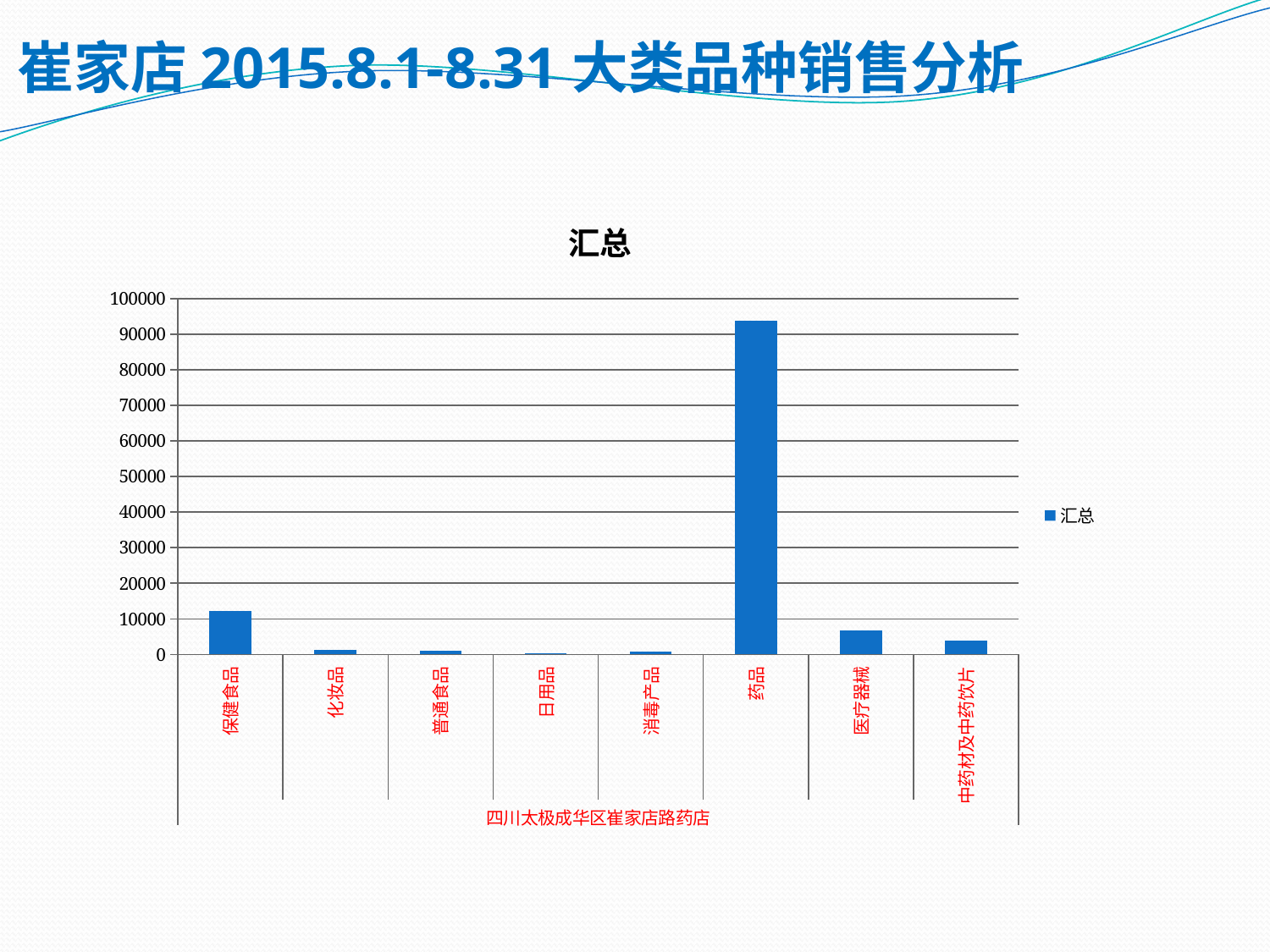
Is the value for 医疗器械 greater or less than 10000? less How many categories are plotted on the x axis of the chart? 8 What store name is printed below the category labels on the x axis? 四川太极成华区崔家店路药店 Which is larger, the value for 药品 or the value for 保健食品? 药品 Which is larger, the value for 保健食品 or the value for 医疗器械? 保健食品 Is the value for 中药材及中药饮片 greater or less than 10000? less What is the title of the chart? 汇总 What kind of chart is shown on the slide? bar chart Is the value for 保健食品 greater or less than 10000? greater How many series does the chart's legend list? 1 Which category has the highest value in the chart? 药品